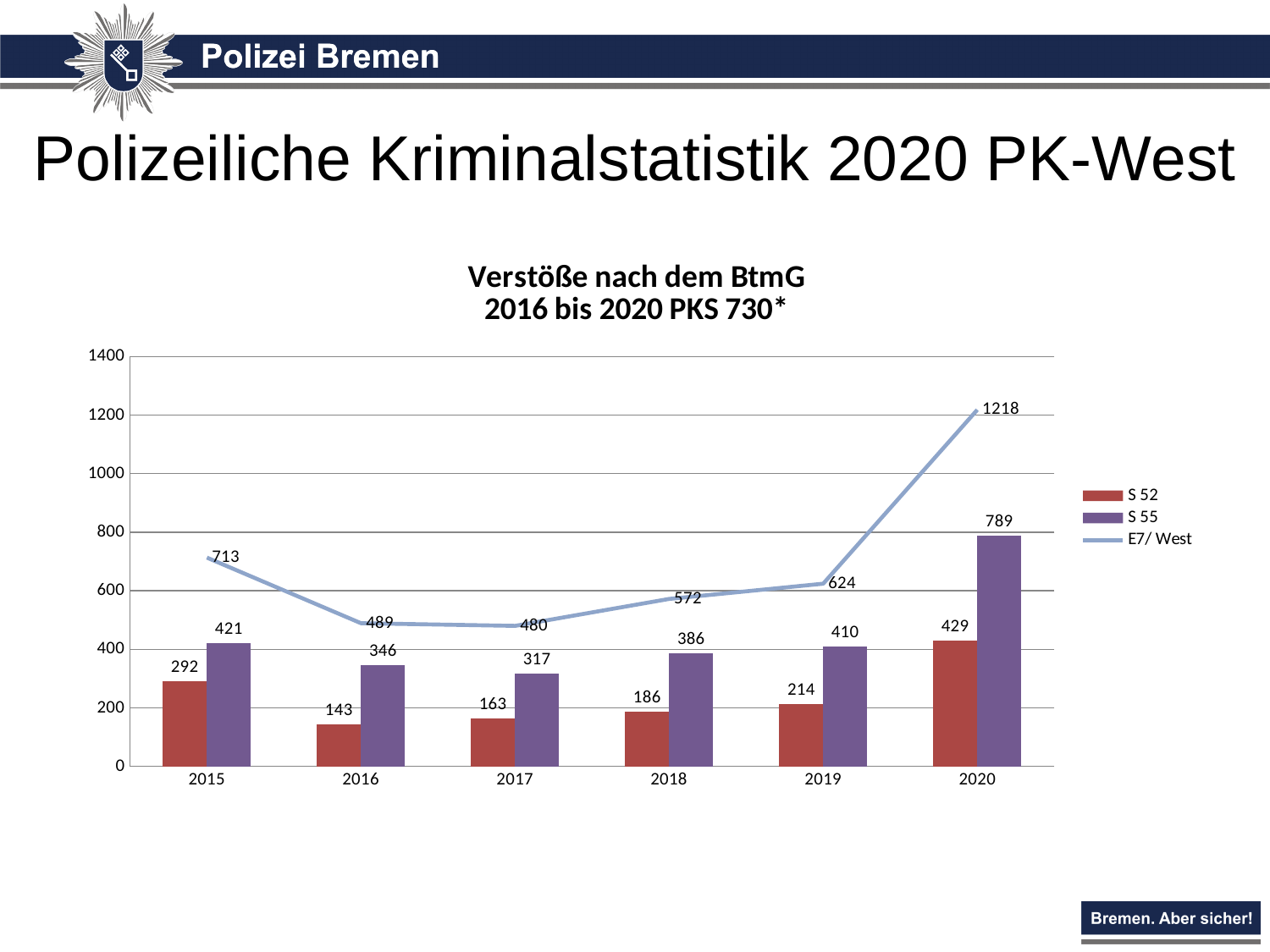
What is the value for S 52 in 2016? 143 What kind of chart is this? Combined bar and line chart How many series does the legend list? 3 What is the difference between the E7/ West values for 2020 and 2019? 594 In which year is the S 52 value lowest? 2016 What is the value for E7/ West in 2017? 480 What is the value for S 55 in 2020? 789 What is the difference between S 55 and S 52 in 2018? 200 Which is larger, the S 55 value in 2015 or the S 55 value in 2019? S 55 in 2015 How many years are shown on the x axis? 6 Does the E7/ West line rise or fall from 2017 to 2020? Rise In which year is the E7/ West value highest? 2020